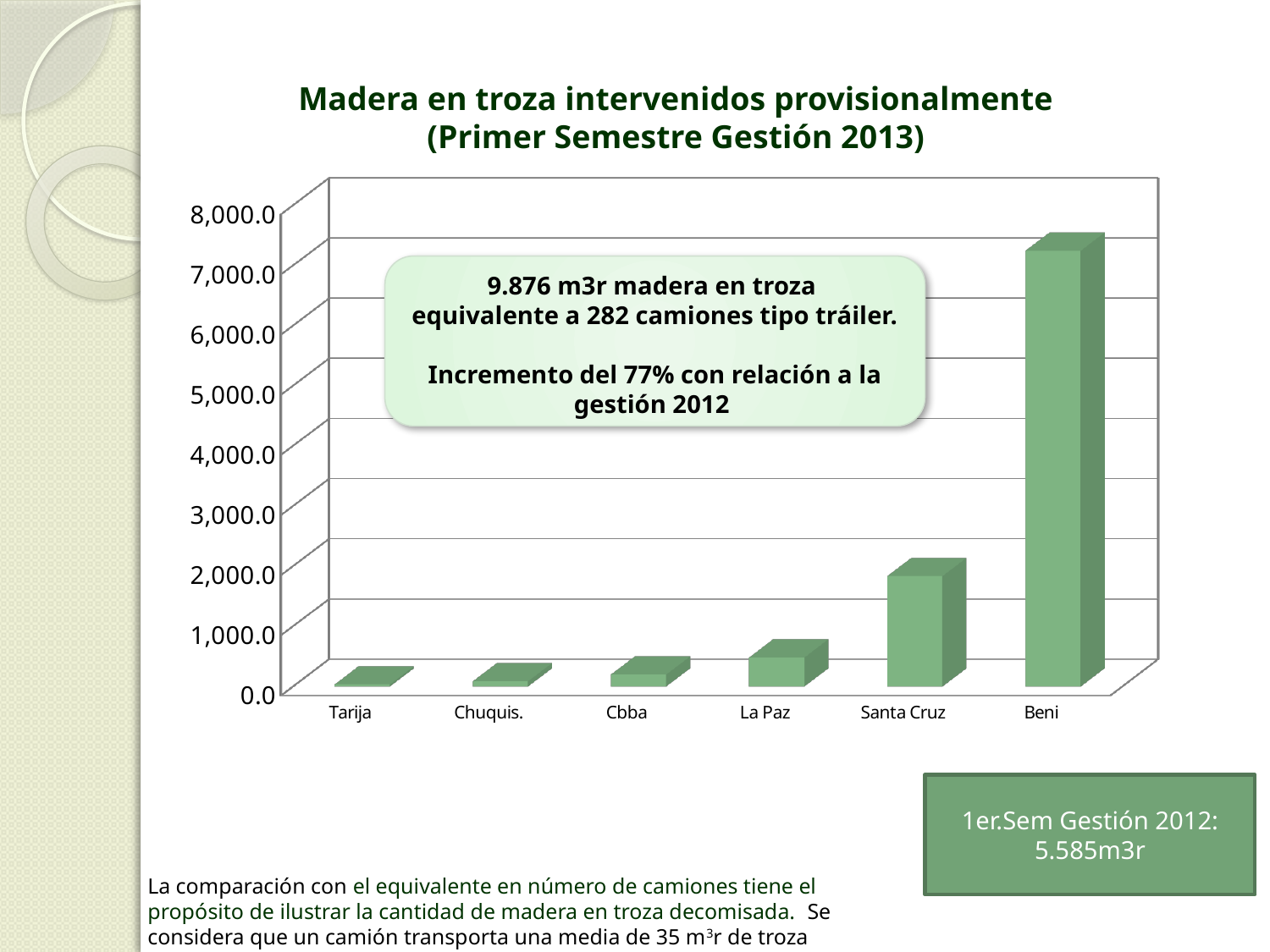
What type of chart is shown on the slide? Bar chart Which category has the highest bar in the chart? Beni What is the title of the chart? Madera en troza intervenidos provisionalmente (Primer Semestre Gestión 2013) Is the value for Beni greater or less than 6,000.0? greater Which bar is taller, Santa Cruz or La Paz? Santa Cruz Do the bar values rise or fall moving from Tarija on the left to Beni on the right? rise Is the value for La Paz greater or less than 1,000.0? less Is the value for Cbba greater or less than 1,000.0? less How many categories (departments) are shown on the x axis of the chart? 6 Which bar is taller, Beni or Santa Cruz? Beni According to the text box on the chart, how many trailer trucks are equivalent to the 9.876 m3r of madera en troza? 282